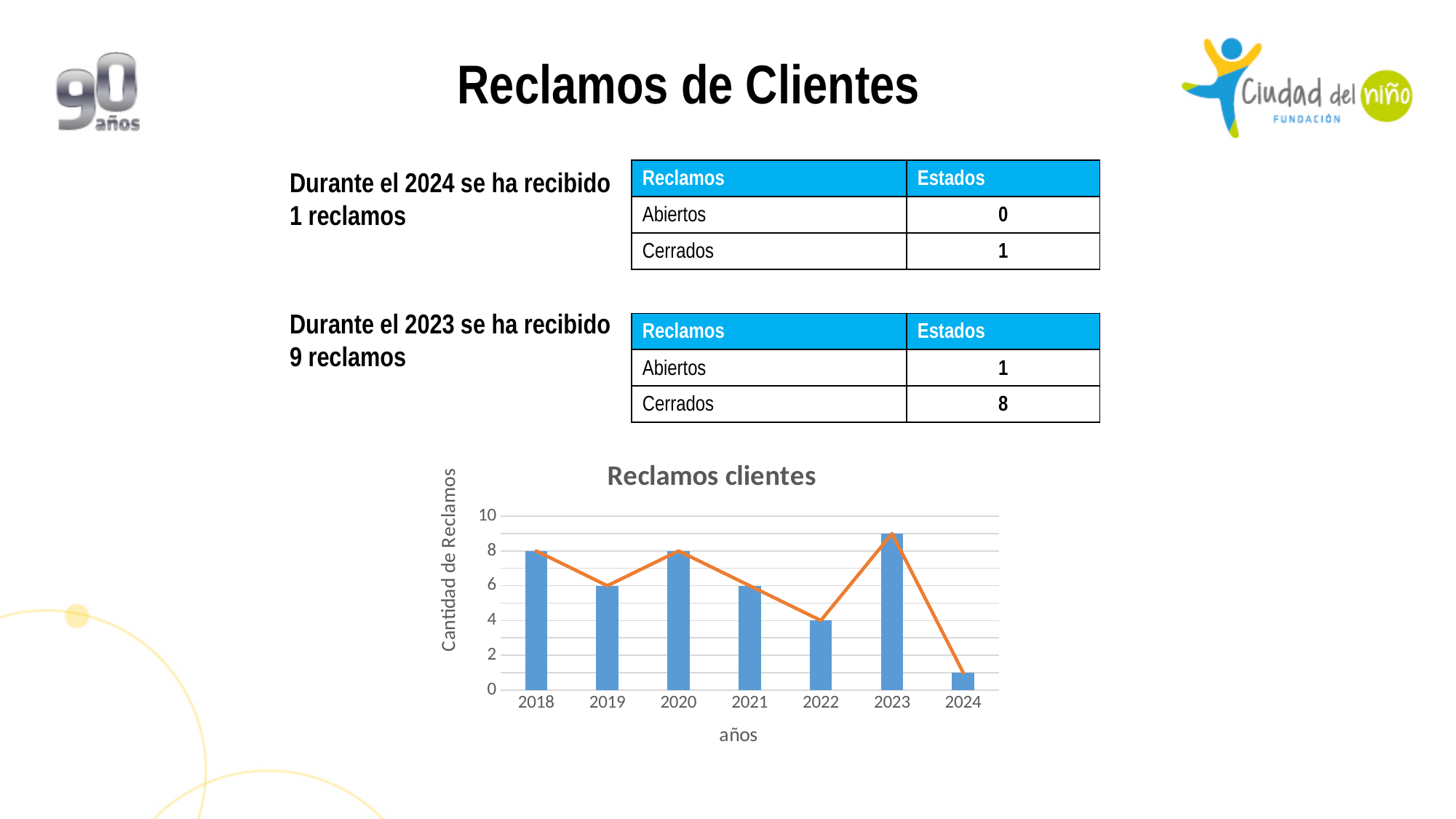
What is the value for 2018 in the Reclamos clientes chart? 8 What is the value for 2019 in the Reclamos clientes chart? 6 Which is larger in the Reclamos clientes chart, the value for 2020 or the value for 2021? 2020 How many years are shown on the x axis of the Reclamos clientes chart? 7 Which year has the highest value in the Reclamos clientes chart? 2023 Which year has the lowest value in the Reclamos clientes chart? 2024 What is the value for 2022 in the Reclamos clientes chart? 4 What is the difference between the values for 2018 and 2022 in the Reclamos clientes chart? 4 Is the value for 2023 in the Reclamos clientes chart greater or less than 8? greater Do the values in the Reclamos clientes chart rise or fall from 2023 to 2024? fall Is the value for 2024 in the Reclamos clientes chart greater or less than 2? less What is the label of the vertical axis in the Reclamos clientes chart? Cantidad de Reclamos